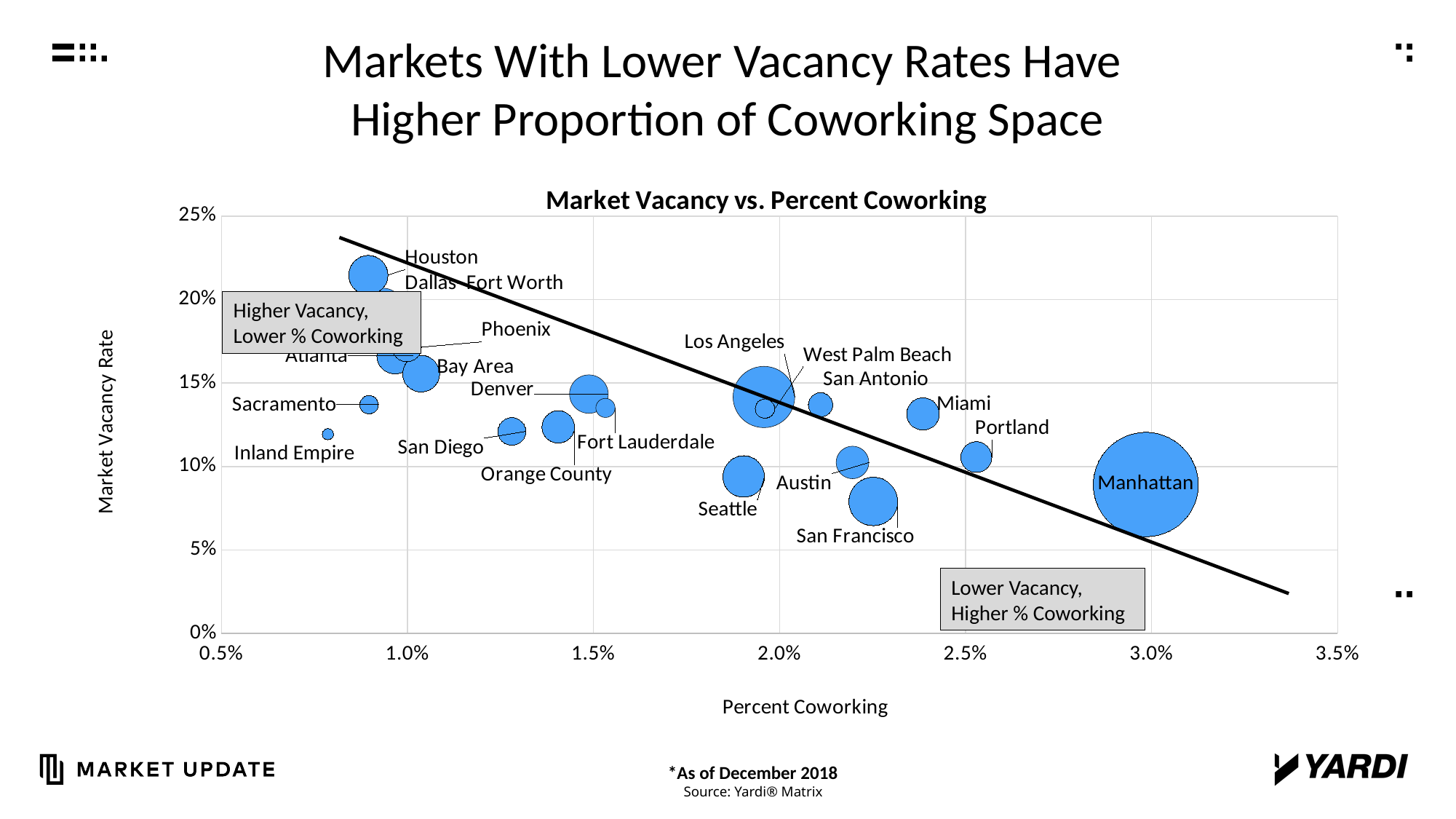
What kind of chart is shown on the slide? Bubble chart Is the percent coworking for Inland Empire greater or less than 1.0%? less Is the percent coworking for Manhattan greater or less than 2.5%? greater Which market has the lowest percent coworking in the chart? Inland Empire Which market has the highest percent coworking in the chart? Manhattan Which market has a higher market vacancy rate, Houston or Seattle? Houston What is the title of the chart? Market Vacancy vs. Percent Coworking What is the label of the vertical axis of the chart? Market Vacancy Rate As percent coworking increases along the x axis, does the market vacancy rate generally rise or fall according to the trend line? fall Is the market vacancy rate for Houston greater or less than 20%? greater Which market has the highest market vacancy rate in the chart? Houston